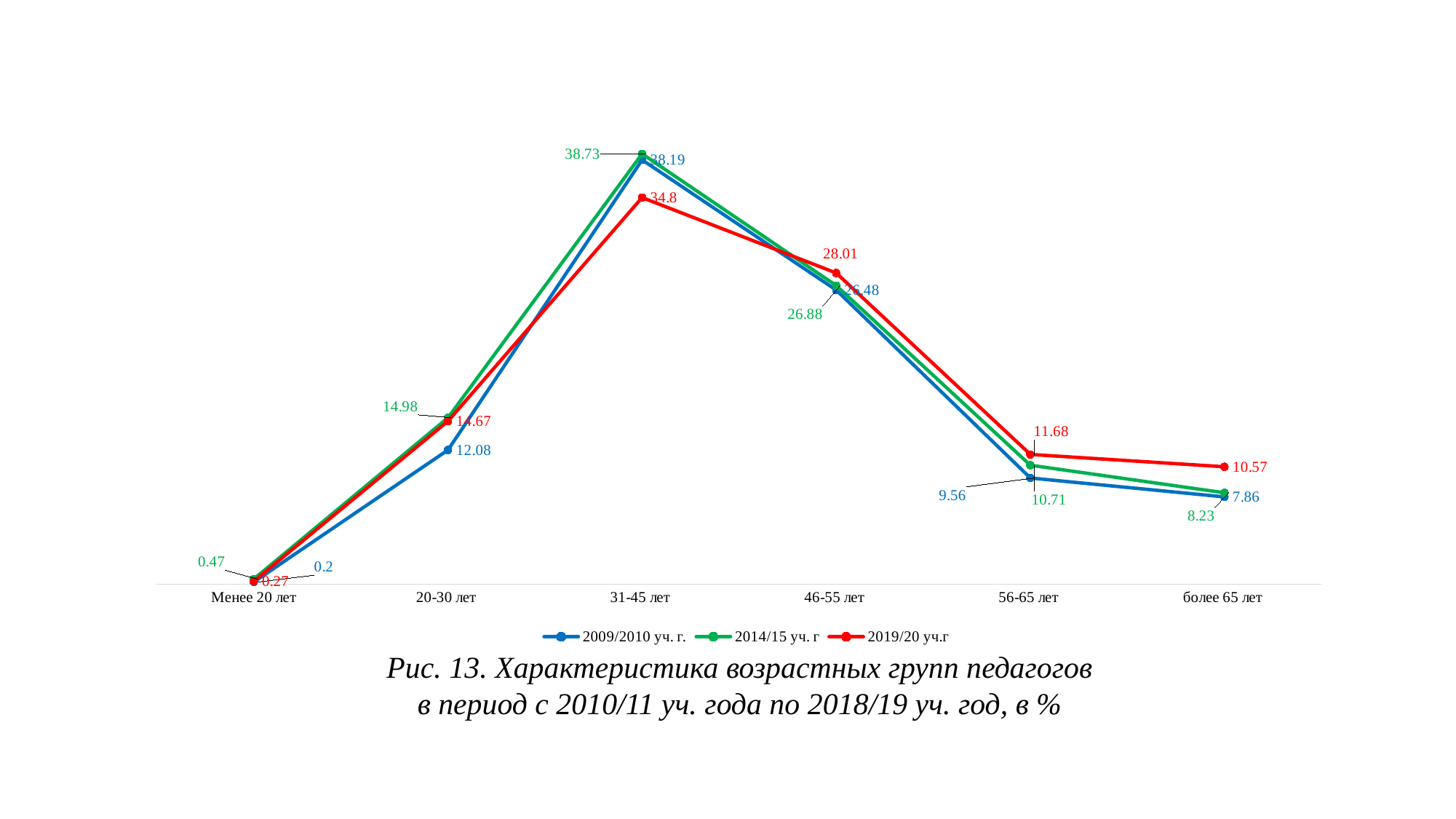
What is the difference between the 2014/15 уч. г and 2009/2010 уч. г. values for 20-30 лет? 2.9 What is the value for 31-45 лет in the 2014/15 уч. г series? 38.73 How many series does the legend list? 3 Which age group has the highest value in the 2019/20 уч.г series? 31-45 лет What is the value for более 65 лет in the 2019/20 уч.г series? 10.57 In the 2009/2010 уч. г. series, do the values rise or fall from 31-45 лет to более 65 лет? Fall What colour is the line for the 2019/20 уч.г series? Red What is the value for 20-30 лет in the 2009/2010 уч. г. series? 12.08 How many age-group categories are shown on the x axis? 6 Which age group has the lowest value in the 2014/15 уч. г series? Менее 20 лет For 46-55 лет, which series has the larger value: 2019/20 уч.г or 2009/2010 уч. г.? 2019/20 уч.г What kind of chart is shown on the slide? Line chart